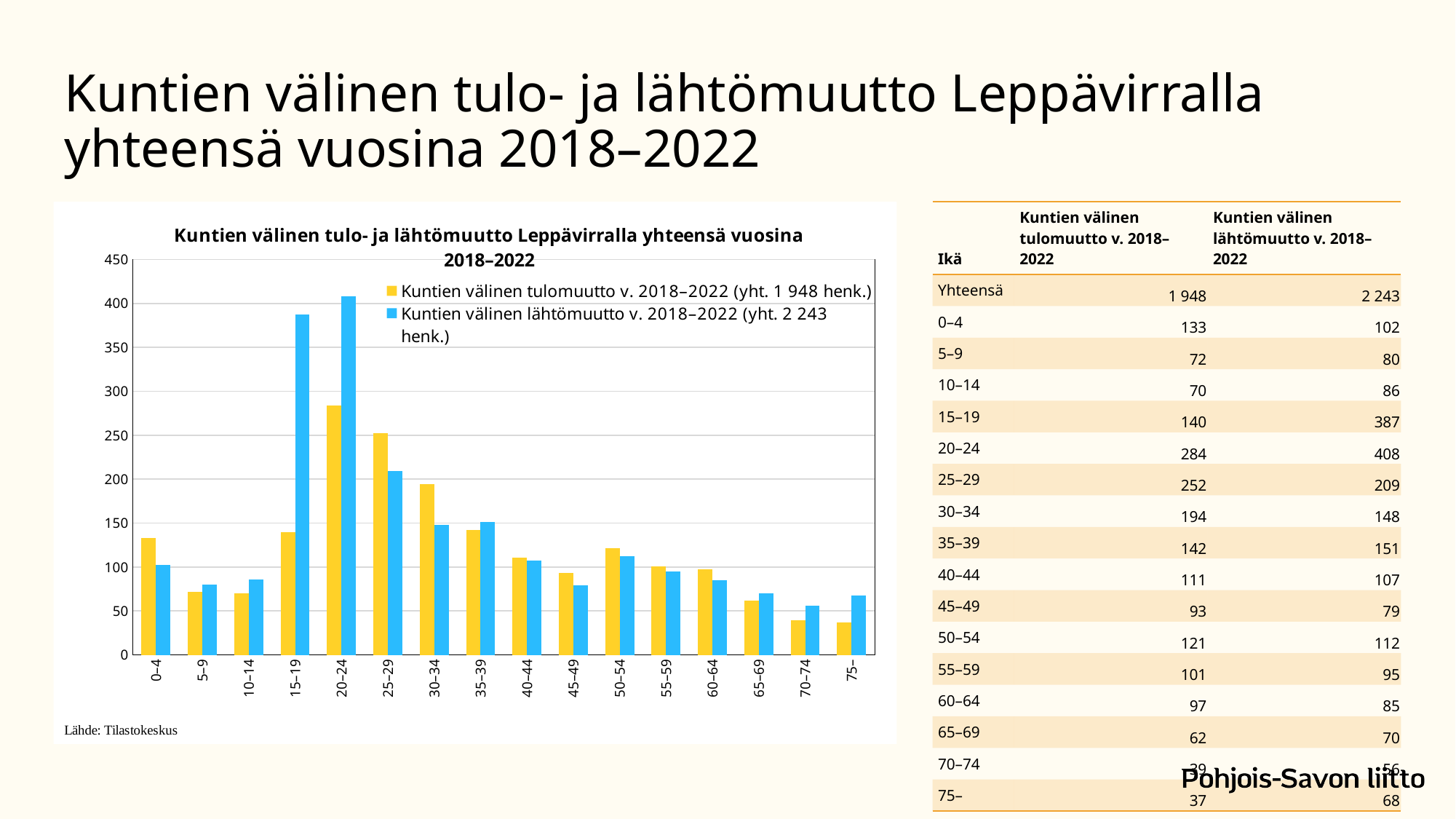
Which age group has the highest value for Kuntien välinen tulomuutto v. 2018–2022? 20–24 Which age group has the highest value for Kuntien välinen lähtömuutto v. 2018–2022? 20–24 How many age groups are shown on the x axis of the chart? 16 According to the legend, what is the total number of persons for Kuntien välinen tulomuutto v. 2018–2022? 1 948 henk. What is the value of Kuntien välinen tulomuutto v. 2018–2022 for the 15–19 age group? 140 How many series does the chart's legend list? 2 For the 25–29 age group, which is larger: tulomuutto or lähtömuutto? tulomuutto What kind of chart is shown on the slide? bar chart What is the value of Kuntien välinen lähtömuutto v. 2018–2022 for the 15–19 age group? 387 What source is cited below the chart? Tilastokeskus Is the value of lähtömuutto for the 15–19 age group greater or less than 350? greater For the 20–24 age group, what is the difference between lähtömuutto (408) and tulomuutto (284)? 124